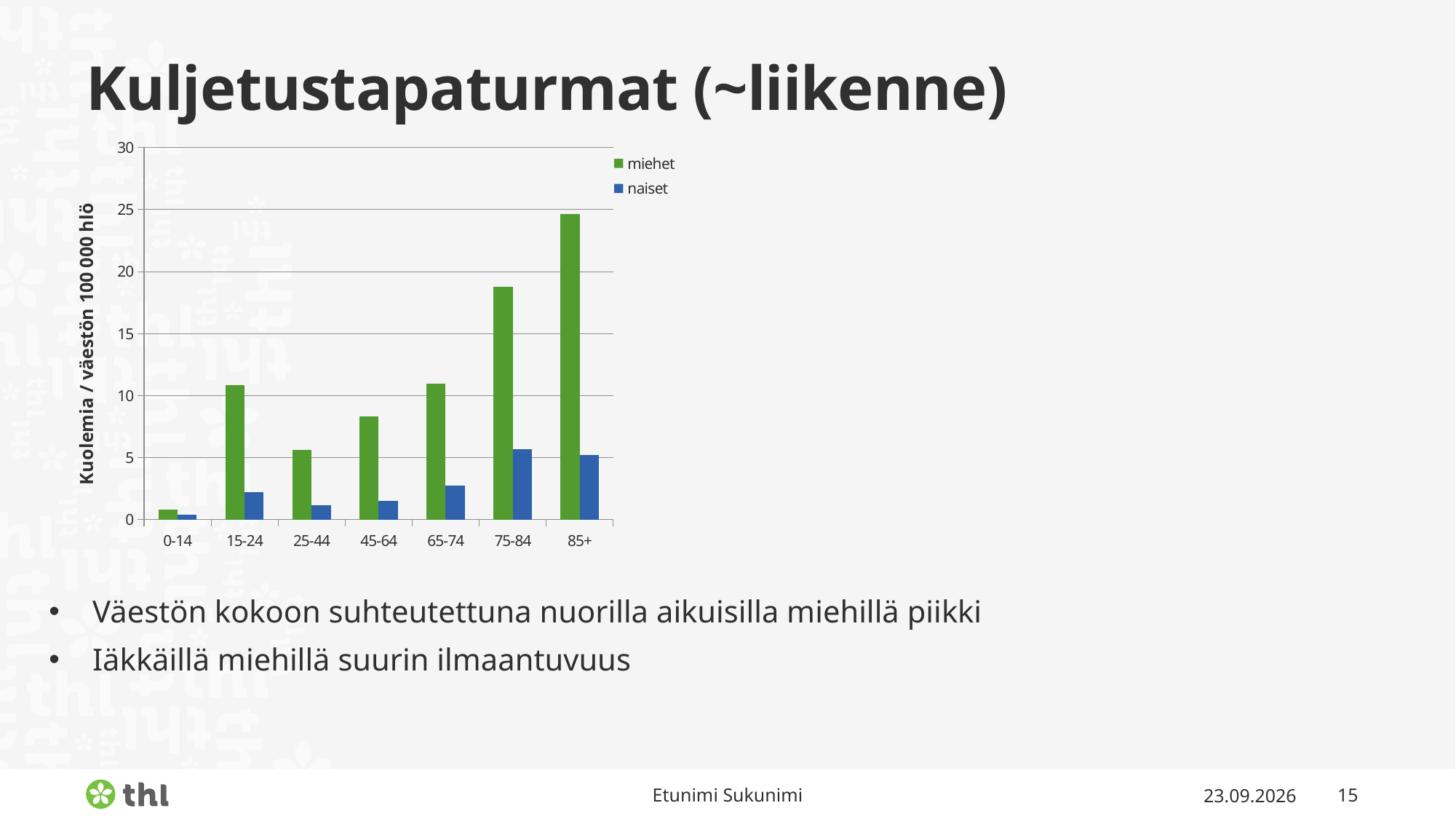
How many series does the chart legend list? 2 Which age group has the highest value for miehet? 85+ Which is larger for miehet: the value for 15-24 or the value for 25-44? 15-24 Which age group has the lowest value for miehet? 0-14 Is the value for miehet in the 75-84 age group greater or less than 15? greater How many age groups are shown on the x axis of the chart? 7 Which is larger for miehet: the value for 45-64 or the value for 65-74? 65-74 Which age group has the lowest value for naiset? 0-14 Is the value for naiset in the 65-74 age group greater or less than 5? less What is the label of the vertical axis of the chart? Kuolemia / väestön 100 000 hlö What kind of chart is shown on the slide? bar chart Is the value for miehet in the 85+ age group greater or less than 20? greater